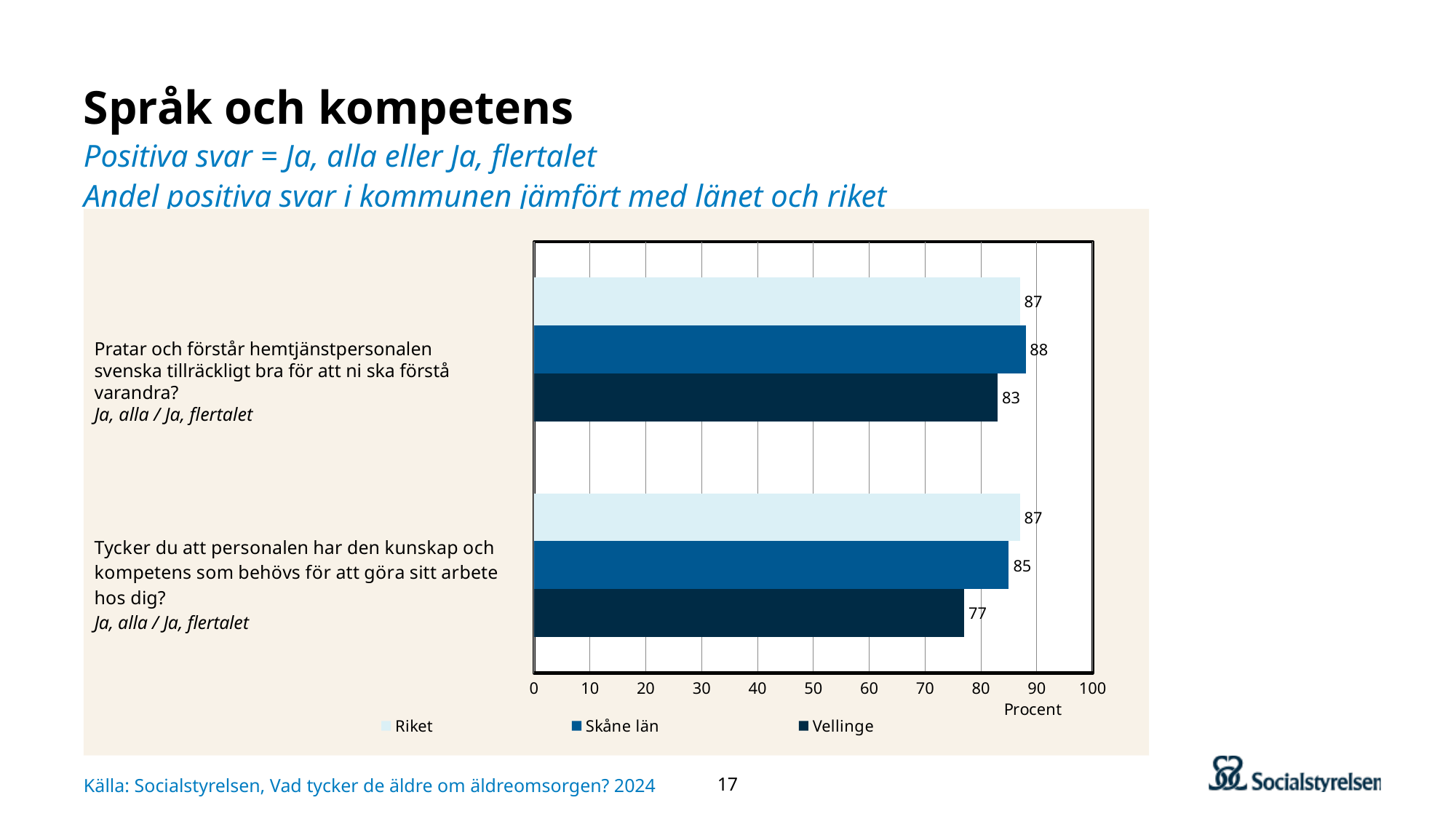
What is the value for Skåne län on the question about whether the staff have the knowledge and competence needed ("Tycker du att personalen har den kunskap och kompetens...")? 85 Which is larger: the Vellinge value for the question about Swedish language skills or the Vellinge value for the question about knowledge and competence? The question about Swedish language skills What is the value for Vellinge on the question about whether the staff speak and understand Swedish well enough ("Pratar och förstår hemtjänstpersonalen svenska tillräckligt bra...")? 83 What is the value for Riket on the question about whether the staff have the knowledge and competence needed? 87 What is the difference between the Riket value and the Vellinge value on the question about whether the staff have the knowledge and competence needed? 10 How many series does the legend list? 3 What type of chart is shown on the slide? Bar chart Which series has the lowest value on the question about whether the staff have the knowledge and competence needed? Vellinge Which series has the highest value on the question about whether the staff speak and understand Swedish well enough? Skåne län How many question categories are plotted in the chart? 2 What unit label is shown on the horizontal axis of the chart? Procent What is the difference between the Skåne län value and the Vellinge value on the question about whether the staff speak and understand Swedish well enough? 5